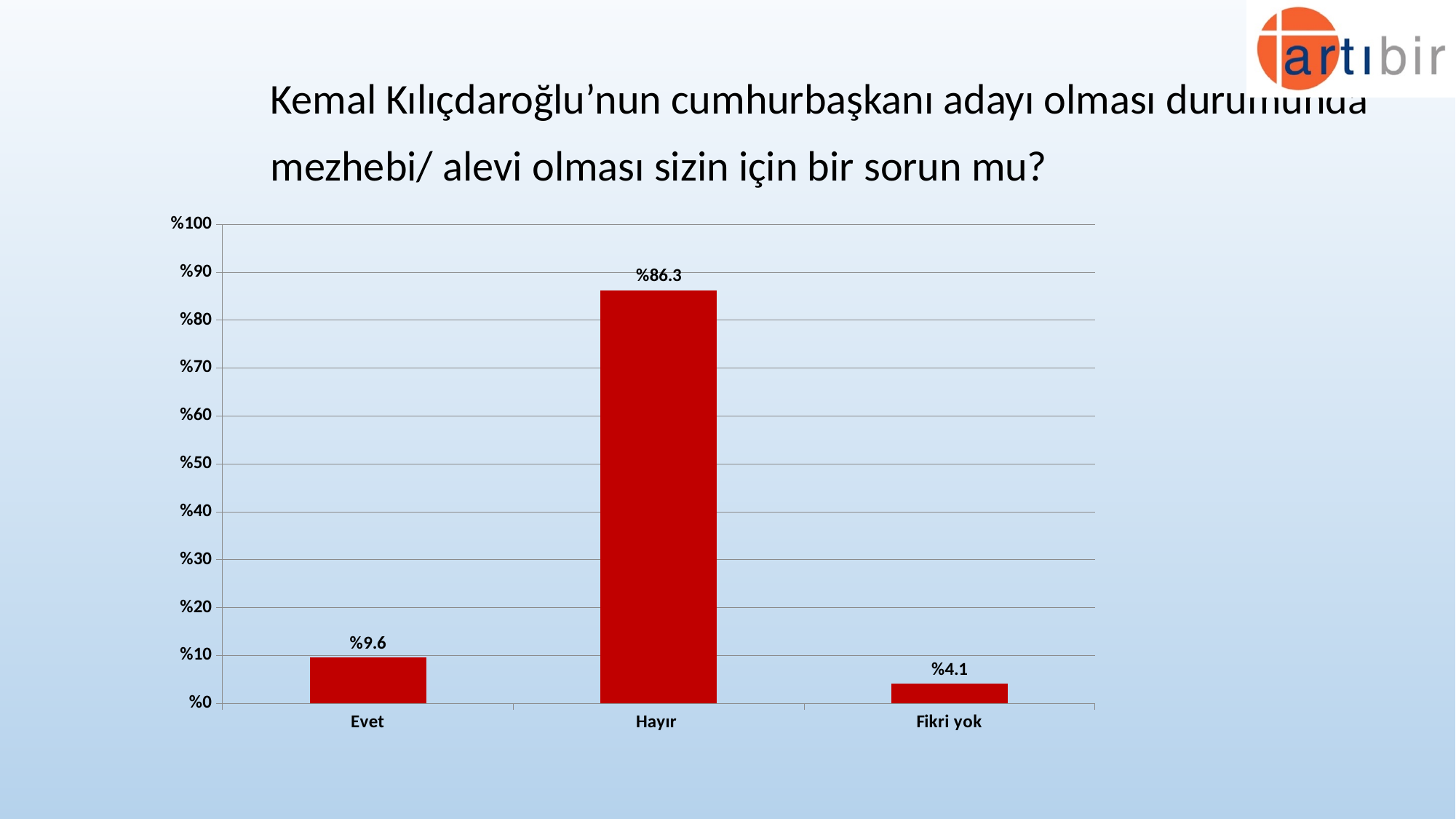
Which category has the highest value? Hayır Which is larger, the value for Evet or the value for Fikri yok? Evet What is the difference between the values for Evet and Fikri yok? %5.5 What is the value for Hayır? %86.3 What kind of chart is shown on the slide? bar chart Is the value for Hayır greater or less than %80? greater What is the value for Evet? %9.6 Which category has the lowest value? Fikri yok What is the value for Fikri yok? %4.1 What colour are the bars in the chart? red How many categories are shown on the x axis? 3 What is the difference between the values for Hayır and Evet? %76.7